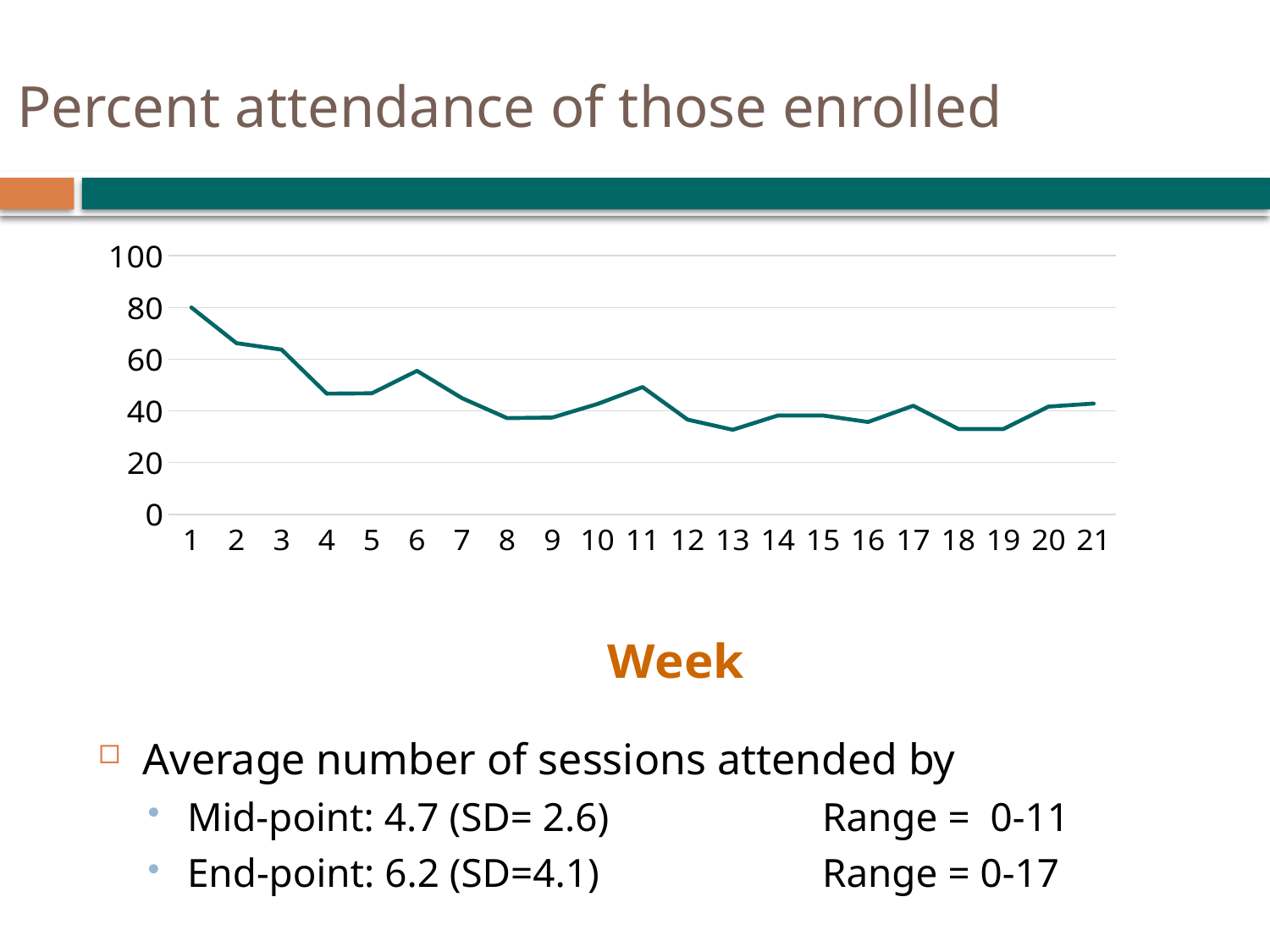
Which is larger, the value for week 11 or the value for week 12? Week 11 Is the value for week 6 greater or less than 40? greater Is the value for week 6 greater or less than 60? less How many weeks are plotted on the x axis of the chart? 21 What is the percent attendance at week 1? 80 Which is larger, the value for week 1 or the value for week 21? Week 1 Which week has the highest percent attendance? Week 1 Is the value for week 2 greater or less than 60? greater What is the label of the x axis of the chart? Week Does percent attendance generally rise or fall from week 1 to week 21? fall What kind of chart is shown on the slide? line chart